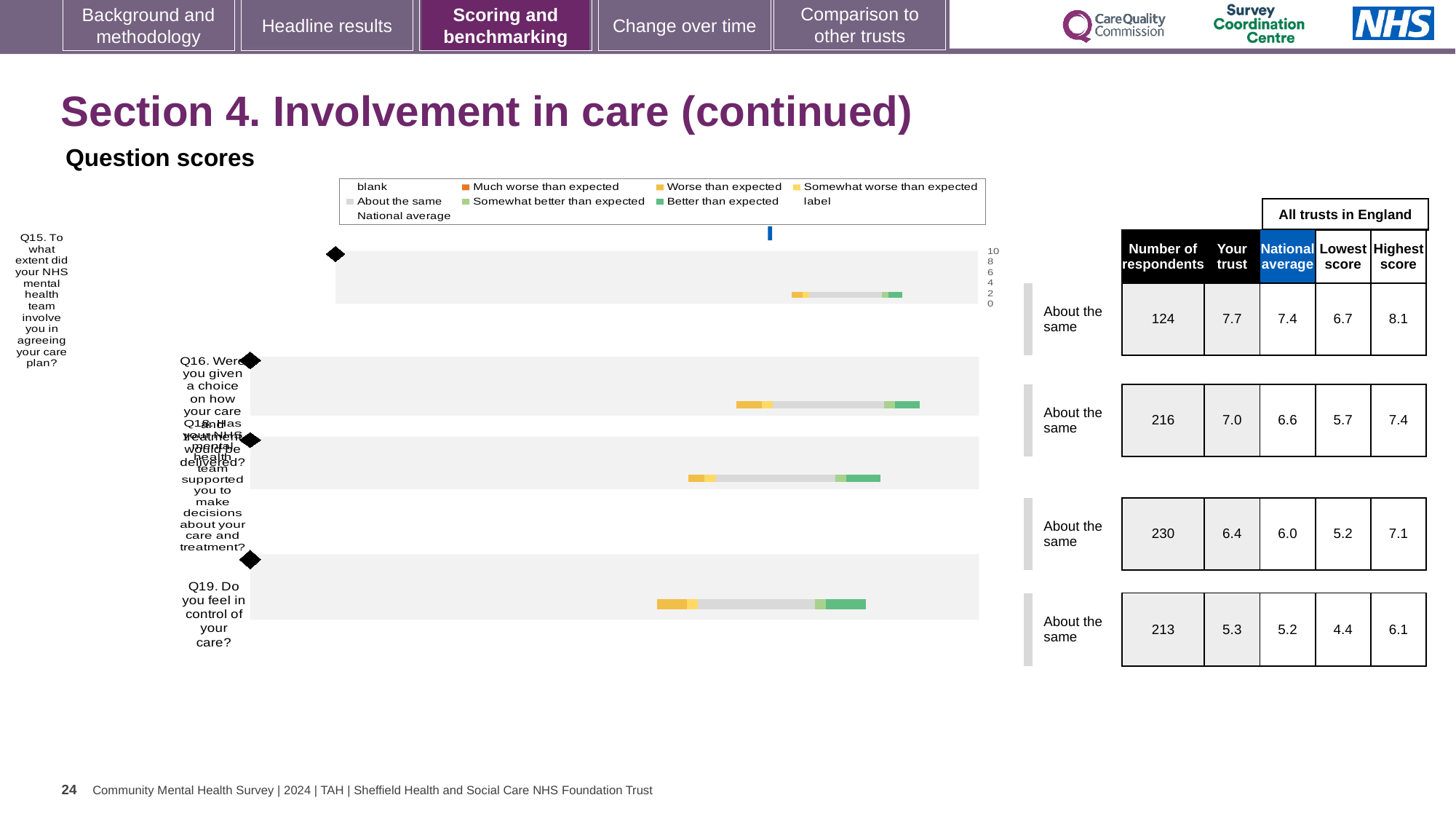
How many questions are plotted in the question scores chart? 4 Which question has the highest 'Your trust' score? Q15 For Q15, which is larger: the 'Your trust' score or the national average? Your trust What benchmark category is shown next to the bar for Q19? About the same What is the national average score for Q19 (feeling in control of your care)? 5.2 What kind of chart is used to show the question scores on this slide? bar chart How many respondents answered Q18 (supported to make decisions about care and treatment)? 230 Which question has the lowest 'Your trust' score? Q19 For Q16, how much higher is the 'Your trust' score than the national average? 0.4 What is the highest score among all trusts in England for Q16? 7.4 What is the difference between the highest and lowest scores across all trusts in England for Q15? 1.4 What is the 'Your trust' score for Q15 (involvement in agreeing your care plan)? 7.7